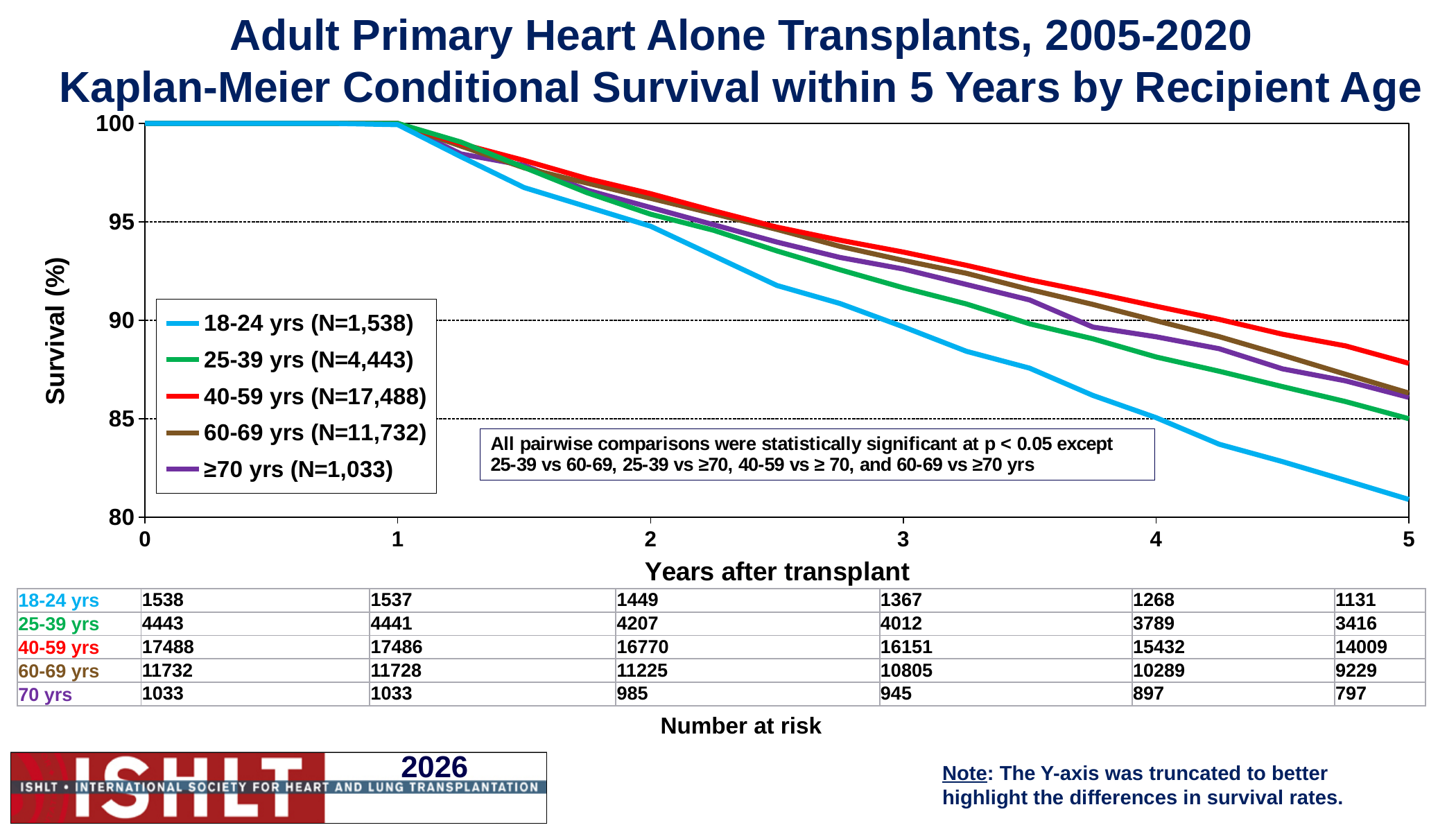
What is the N shown in the legend for the 60-69 yrs group? N=11,732 Which recipient age group has the highest survival at 5 years after transplant? 40-59 yrs What kind of chart is shown on the slide? line chart At 3 years after transplant, which group has higher survival: 40-59 yrs or 18-24 yrs? 40-59 yrs Is the survival value for the 40-59 yrs group at 5 years greater or less than 85? greater Is the survival value for the ≥70 yrs group at 3 years greater or less than 90? greater Which recipient age group has the lowest survival at 5 years after transplant? 18-24 yrs Is the survival value for the 18-24 yrs group at 5 years greater or less than 85? less According to the number at risk table, how many 18-24 yrs recipients were at risk at 5 years? 1131 According to the number at risk table, how many 40-59 yrs recipients were at risk at year 0? 17488 Do the survival curves rise or fall as years after transplant increase? fall How many series does the legend list? 5